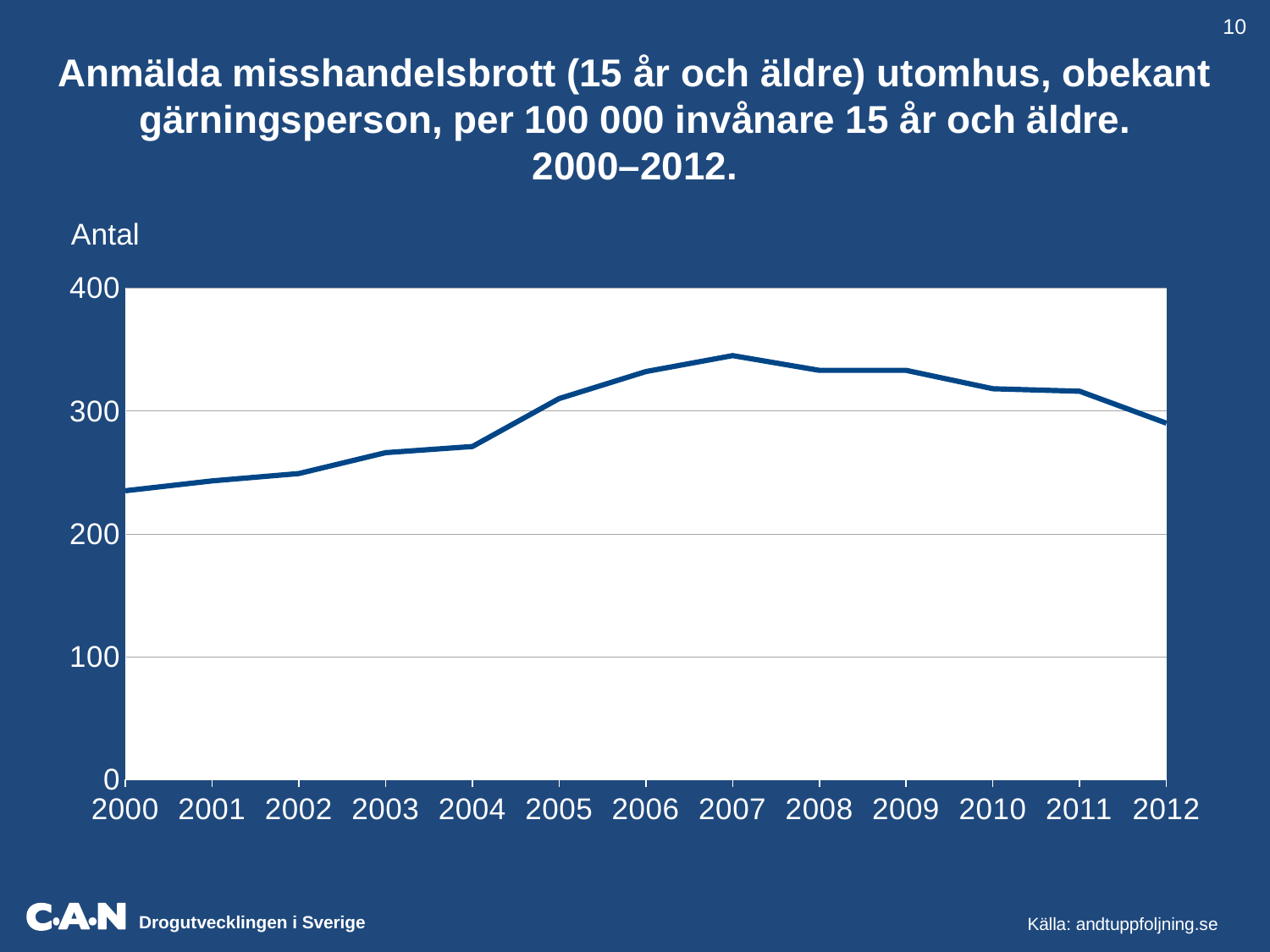
What kind of chart is shown on the slide? line chart In which year is the plotted value highest? 2007 How many years are plotted along the x axis? 13 Is the value for 2007 greater or less than 300? greater Is the value for 2004 greater or less than 300? less Which year has the larger value, 2003 or 2006? 2006 Do the values rise or fall from 2000 to 2007? rise Is the value for 2000 greater or less than 200? greater In which year is the plotted value lowest? 2000 What is the label shown above the vertical axis? Antal Do the values rise or fall from 2007 to 2012? fall